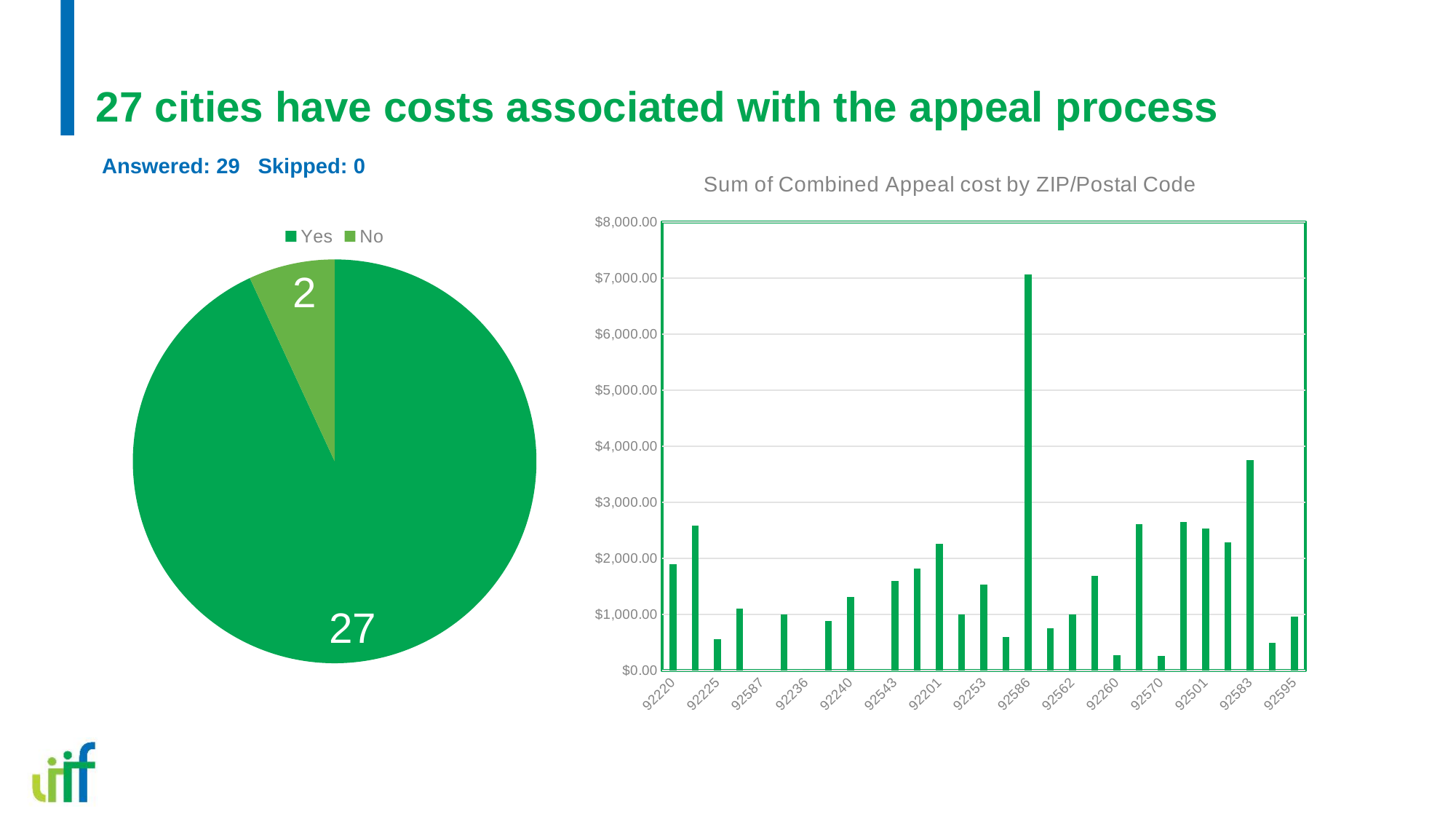
On the pie chart, how many respondents answered No? 2 On the 'Sum of Combined Appeal cost by ZIP/Postal Code' chart, is the value for 92260 greater or less than $1,000.00? less On the 'Sum of Combined Appeal cost by ZIP/Postal Code' chart, is the value for 92583 greater or less than $3,000.00? greater On the pie chart, how many respondents answered Yes? 27 On the pie chart, which slice is larger, Yes or No? Yes How many entries does the legend of the pie chart list? 2 On the 'Sum of Combined Appeal cost by ZIP/Postal Code' chart, which ZIP code has the larger appeal cost, 92586 or 92220? 92586 On the 'Sum of Combined Appeal cost by ZIP/Postal Code' chart, is the value for 92586 greater or less than $6,000.00? greater What kind of chart is the 'Sum of Combined Appeal cost by ZIP/Postal Code' chart? bar chart On the 'Sum of Combined Appeal cost by ZIP/Postal Code' chart, which ZIP code has the highest appeal cost? 92586 On the pie chart, what is the difference between the Yes count and the No count? 25 What is the title of the chart on the right side of the slide? Sum of Combined Appeal cost by ZIP/Postal Code